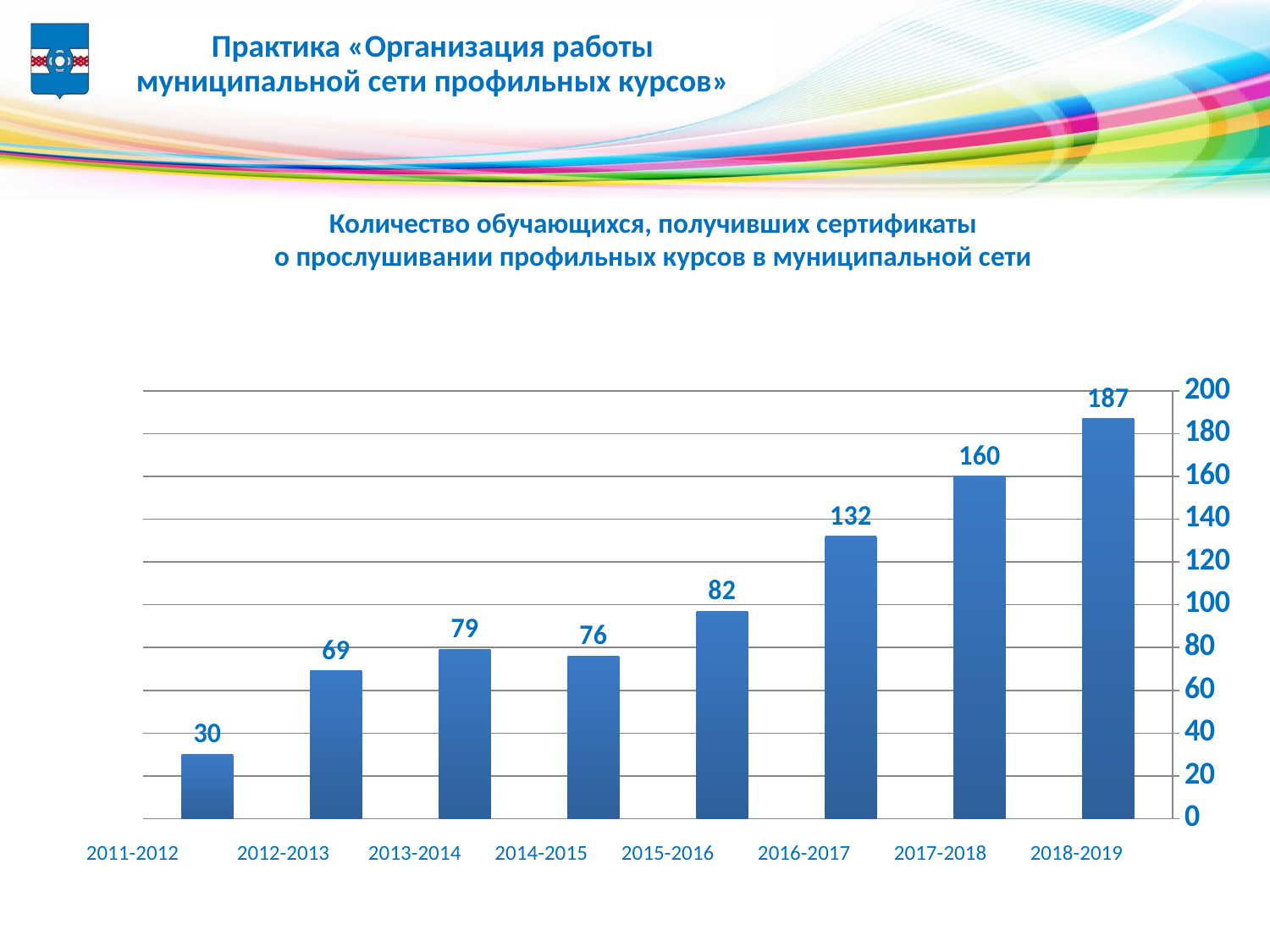
Which year has the highest value? 2018-2019 What kind of chart is shown on the slide? bar chart What is the value for 2016-2017? 132 What is the value for 2011-2012? 30 What is the difference between the values for 2018-2019 and 2017-2018? 27 How many years are shown on the x axis? 8 What is the difference between the values for 2013-2014 and 2014-2015? 3 What is the value for 2014-2015? 76 Which year has the lowest value? 2011-2012 Is the value for 2017-2018 greater or less than 140? greater Do the values generally rise or fall from 2011-2012 to 2018-2019? rise Which is larger, the value for 2012-2013 or the value for 2015-2016? 2015-2016